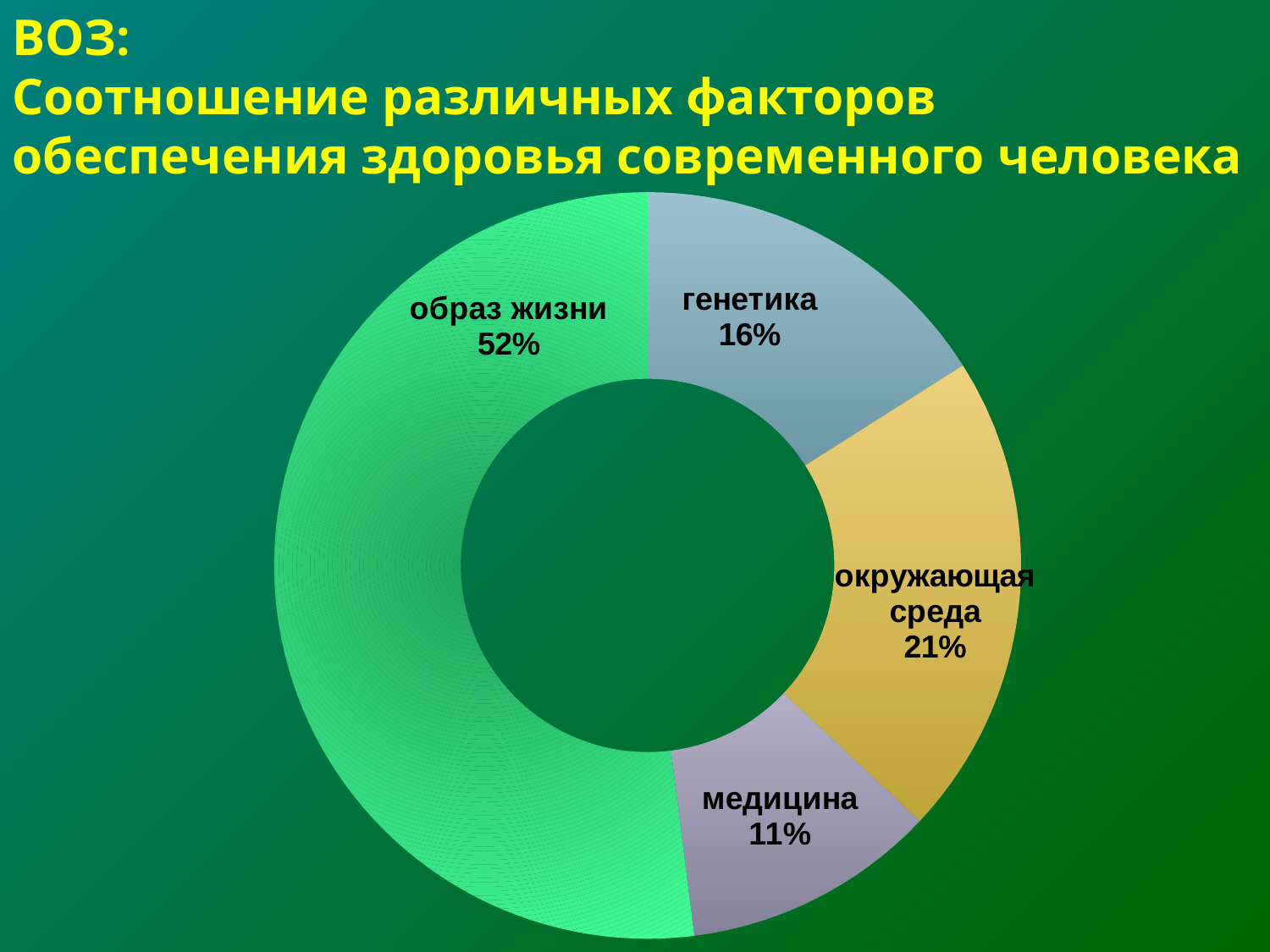
What is the difference between the shares of образ жизни and окружающая среда? 31% Which is larger, the share for окружающая среда or the share for генетика? окружающая среда What is the value shown for медицина? 11% How many categories are shown in the chart? 4 What is the difference between the shares of генетика and медицина? 5% What is the value shown for генетика? 16% What is the value shown for окружающая среда? 21% What kind of chart is shown on the slide? doughnut (pie) chart What colour is the slice for образ жизни? green What share of the chart does образ жизни account for? 52% Which factor has the largest share? образ жизни Which factor has the smallest share? медицина